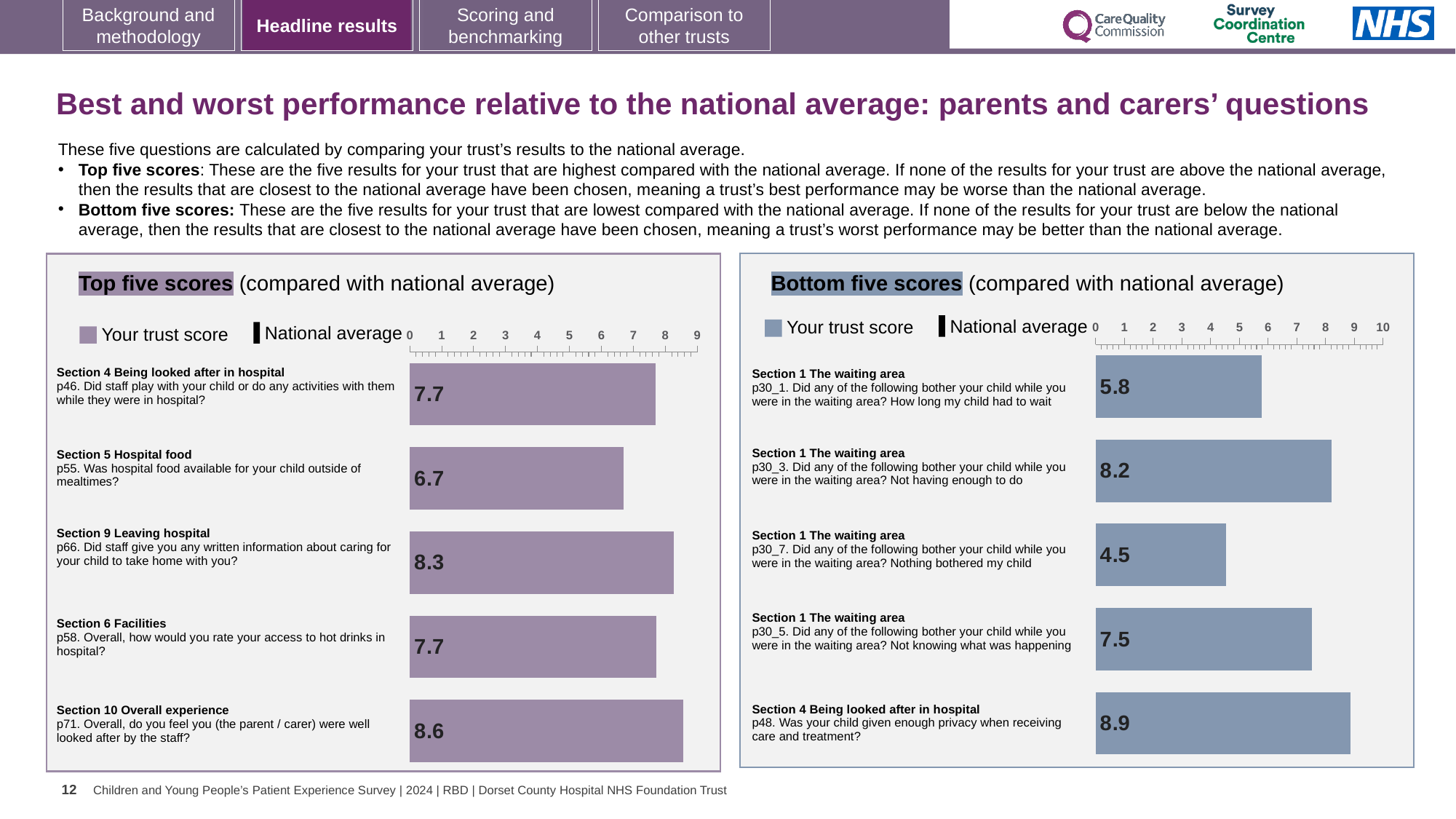
In the Bottom five scores chart, which has the larger trust score, p30_1 or p30_5? p30_5 In the Top five scores chart, which question has the highest trust score? p71. Overall, do you feel you (the parent / carer) were well looked after by the staff? In the Bottom five scores chart, what is the difference between the trust scores for p48 and p30_7? 4.4 What type of chart is the Bottom five scores chart? Bar chart How many questions are shown in the Top five scores chart? 5 In the Bottom five scores chart, which question has the lowest trust score? p30_7. Did any of the following bother your child while you were in the waiting area? Nothing bothered my child In the Top five scores chart, what is the difference between the trust scores for p66 and p55? 1.6 How many entries does the legend of the Top five scores chart list? 2 In the Top five scores chart, what is the trust score for p55 (Was hospital food available for your child outside of mealtimes)? 6.7 In the Bottom five scores chart, what is the trust score for p48 (Was your child given enough privacy when receiving care and treatment)? 8.9 In the Top five scores chart, what is the trust score for p71 (Overall, do you feel you were well looked after by the staff)? 8.6 In the Bottom five scores chart, what is the trust score for p30_7 (Nothing bothered my child)? 4.5